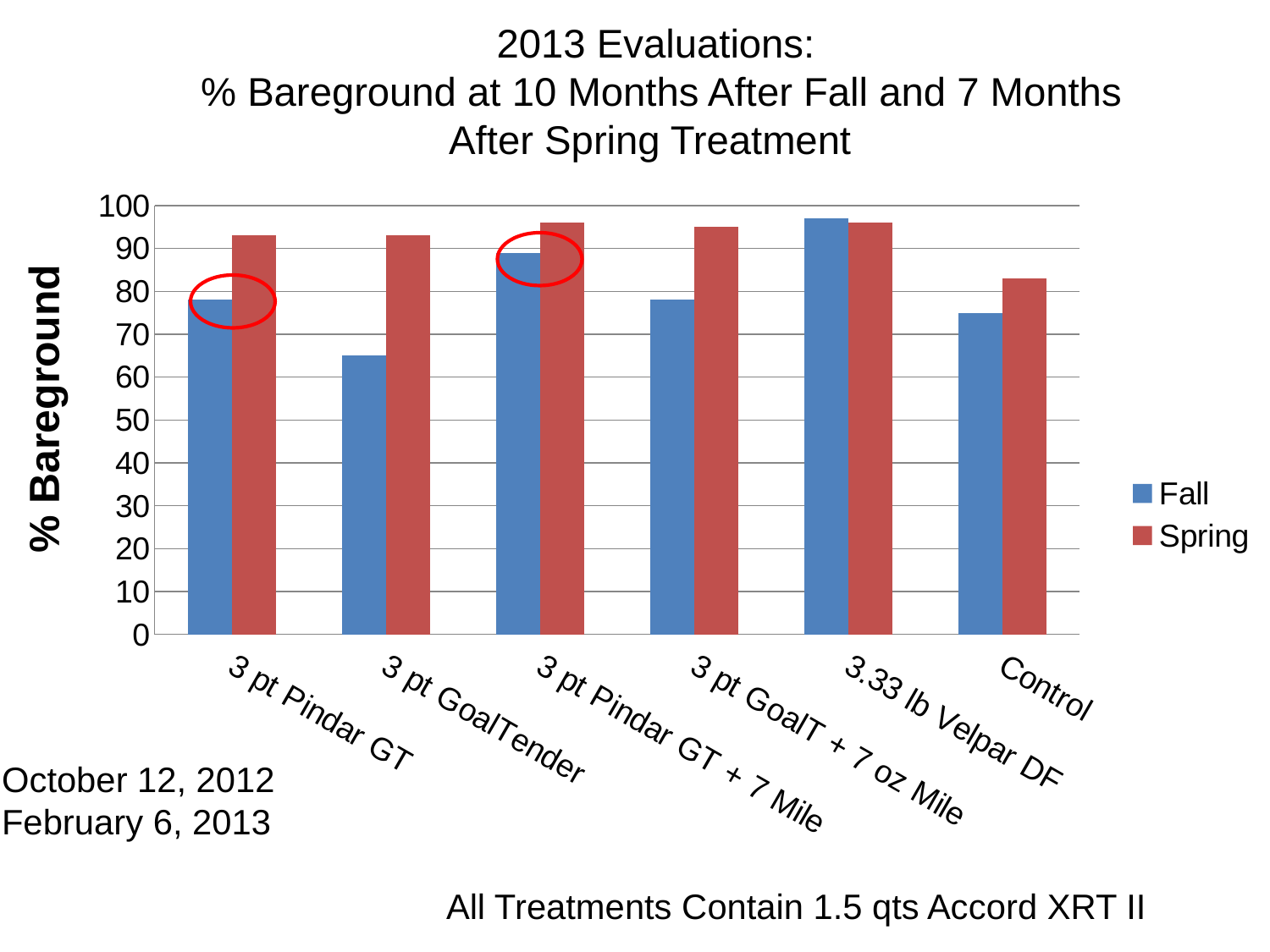
For 3 pt GoalTender, which is larger: the Fall or the Spring % Bareground? Spring Which treatment has the lowest Spring % Bareground? Control Is the Spring value for Control greater or less than 90? less What kind of chart is shown on the slide? bar chart How many series does the legend list? 2 For Control, which is larger: the Fall or the Spring % Bareground? Spring What is the label on the y axis? % Bareground Which treatment has the highest Fall % Bareground? 3.33 lb Velpar DF Is the Fall value for 3.33 lb Velpar DF greater or less than 90? greater Which treatment has the lowest Fall % Bareground? 3 pt GoalTender Is the Fall value for 3 pt GoalTender greater or less than 70? less How many treatment categories are shown on the x axis? 6